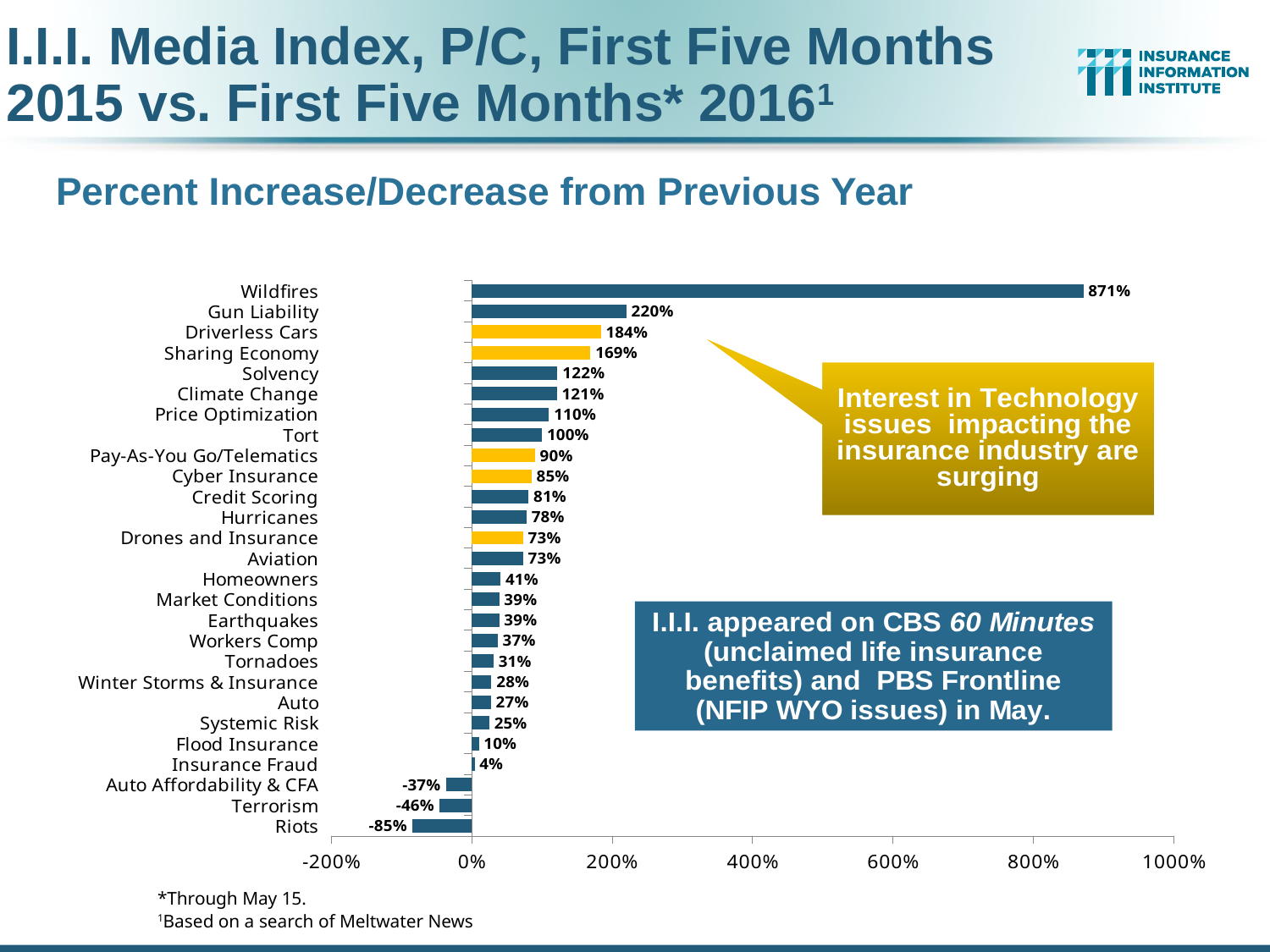
Which category has the highest percent change? Wildfires What is the percent change shown for Cyber Insurance? 85% How many categories are plotted in the chart? 27 What kind of chart is shown on the slide? Bar chart What is the percent change shown for Terrorism? -46% Which category has the lowest percent change? Riots What is the percent change shown for Wildfires? 871% What is the percent change shown for Riots? -85% What is the difference between the percent change for Gun Liability and Driverless Cars? 36% How many bars are coloured yellow in the chart? 5 Is the value for Wildfires greater or less than 800%? greater Which has a larger percent change, Solvency or Tort? Solvency